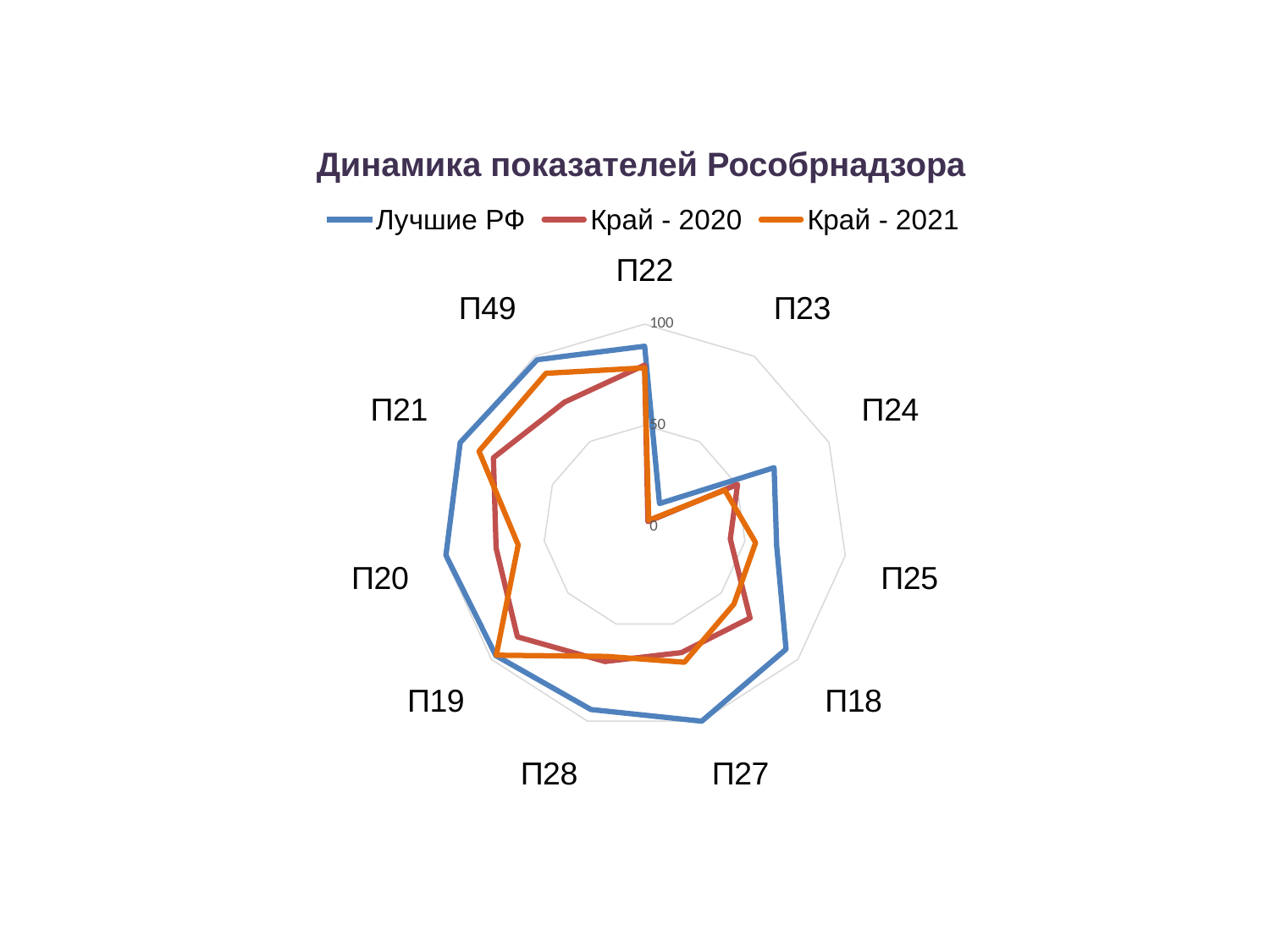
Is the value of Край - 2020 for П23 greater or less than 50? less Is the value of Край - 2021 for П22 greater or less than 50? greater What kind of chart is shown on the slide? radar chart How many categories (axes) does the radar chart have? 11 How many series does the legend list? 3 For П24, which series has the larger value: Лучшие РФ or Край - 2020? Лучшие РФ For П27, which series has the larger value: Лучшие РФ or Край - 2021? Лучшие РФ What is the title of the chart? Динамика показателей Рособрнадзора For which category is the value of Лучшие РФ lowest? П23 Is the value of Лучшие РФ for П23 greater or less than 50? less Which series is drawn in blue? Лучшие РФ